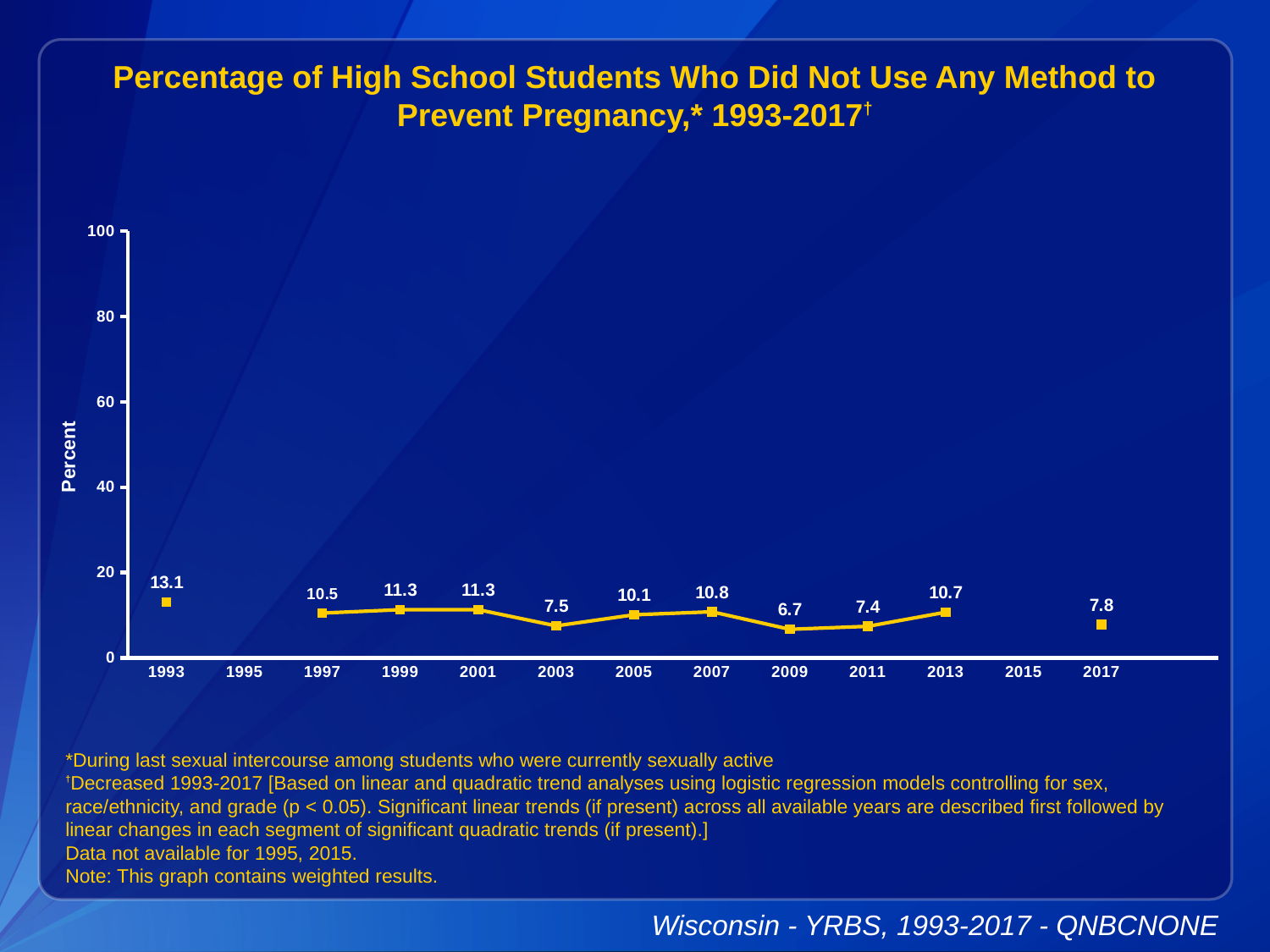
Overall, do the values rise or fall from 1993 to 2017? fall What kind of chart is this? line chart What is the label on the y axis? Percent What is the value for 1993? 13.1 Which year has the highest value? 1993 How many years have data points plotted? 11 Which year has the lowest value? 2009 What is the difference between the values for 1993 and 2017? 5.3 Which is larger, the value for 2007 or the value for 2011? 2007 What is the value for 2009? 6.7 What is the value for 2017? 7.8 Is the value for 2013 greater or less than 20? less